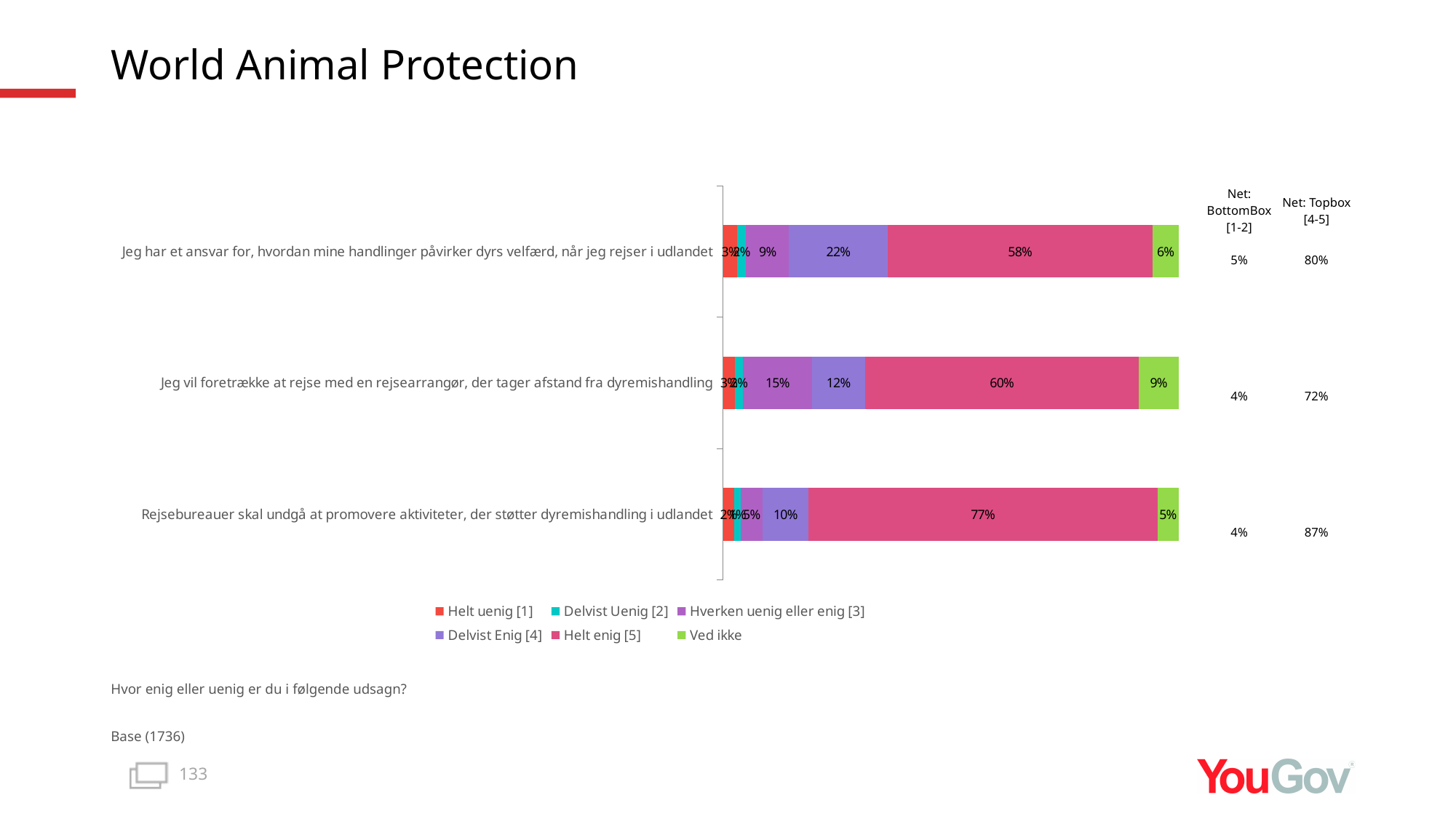
How many series does the legend list? 6 What percentage answered 'Delvist Enig [4]' for the statement 'Jeg har et ansvar for, hvordan mine handlinger påvirker dyrs velfærd, når jeg rejser i udlandet'? 22% Which statement has a larger 'Hverken uenig eller enig [3]' share: 'Jeg vil foretrække at rejse med en rejsearrangør...' or 'Jeg har et ansvar for, hvordan mine handlinger...'? Jeg vil foretrække at rejse med en rejsearrangør, der tager afstand fra dyremishandling What percentage answered 'Ved ikke' for the statement 'Jeg vil foretrække at rejse med en rejsearrangør, der tager afstand fra dyremishandling'? 9% What is the difference in 'Helt enig [5]' share between 'Rejsebureauer skal undgå at promovere aktiviteter...' and 'Jeg har et ansvar for, hvordan mine handlinger påvirker dyrs velfærd...'? 19 percentage points What kind of chart is shown on the slide? Stacked bar chart Which statement has the lowest 'Net: Topbox [4-5]' value? Jeg vil foretrække at rejse med en rejsearrangør, der tager afstand fra dyremishandling Which statement has the highest share of 'Helt enig [5]' responses? Rejsebureauer skal undgå at promovere aktiviteter, der støtter dyremishandling i udlandet What percentage answered 'Helt enig [5]' for the statement 'Rejsebureauer skal undgå at promovere aktiviteter, der støtter dyremishandling i udlandet'? 77% What is the base (number of respondents) stated on the slide? 1736 What is the 'Net: Topbox [4-5]' value for the statement 'Jeg vil foretrække at rejse med en rejsearrangør, der tager afstand fra dyremishandling'? 72% How many statements (bars) are plotted in the chart? 3